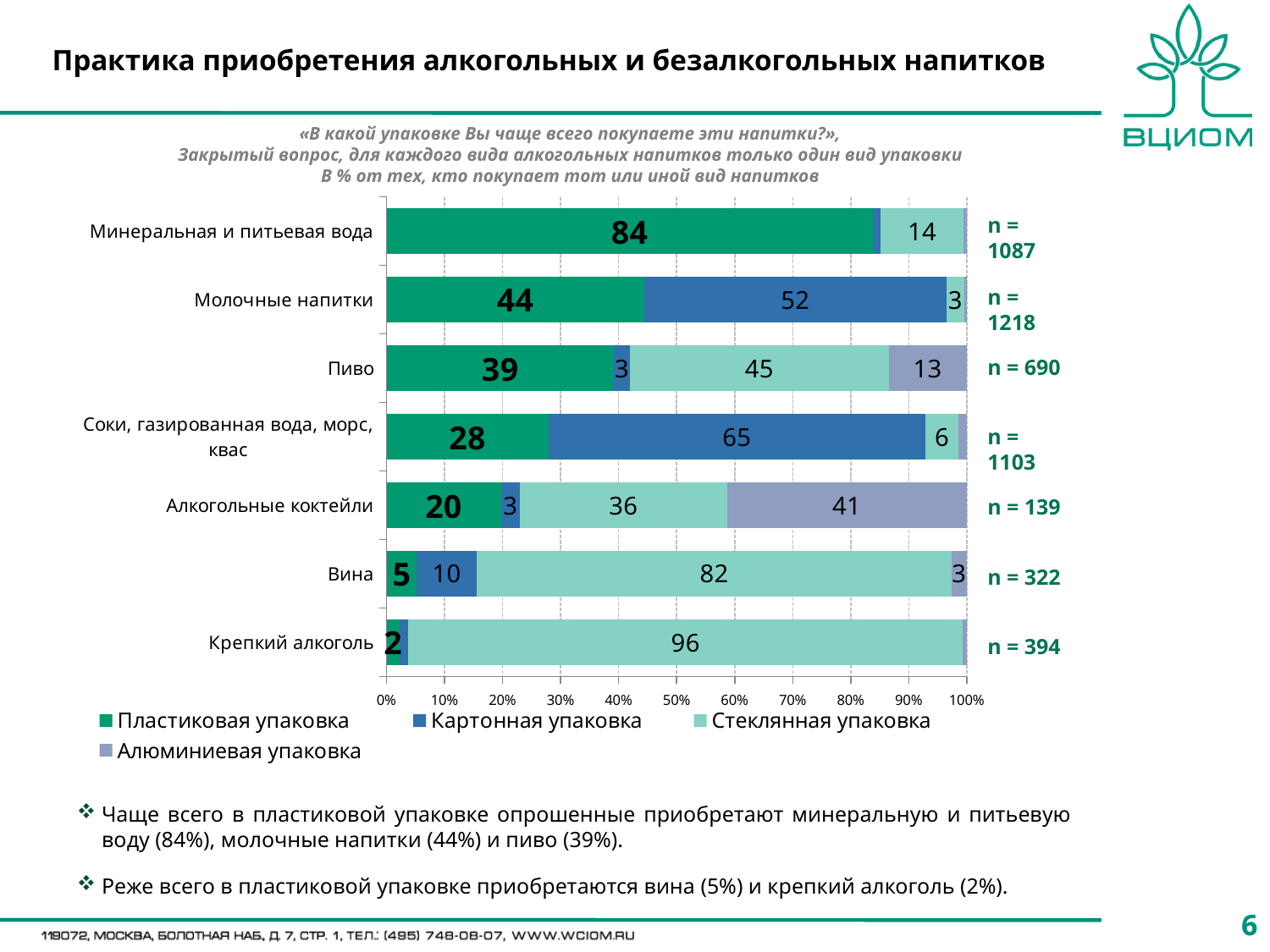
Which drink category has the lowest value for Пластиковая упаковка? Крепкий алкоголь How many series does the legend list? 4 What is the value for Алюминиевая упаковка for Алкогольные коктейли? 41 Which is larger: the Картонная упаковка value for Соки, газированная вода, морс, квас or for Молочные напитки? Соки, газированная вода, морс, квас How many drink categories are plotted in the chart? 7 What is the value for Стеклянная упаковка for Крепкий алкоголь? 96 What is the value for Картонная упаковка for Молочные напитки? 52 What is the difference between the Стеклянная упаковка values for Вина and Пиво? 37 Which drink category has the highest value for Пластиковая упаковка? Минеральная и питьевая вода What kind of chart is shown on the slide? Stacked bar chart What is the sample size (n) shown for Пиво? n = 690 What is the value for Пластиковая упаковка for Минеральная и питьевая вода? 84